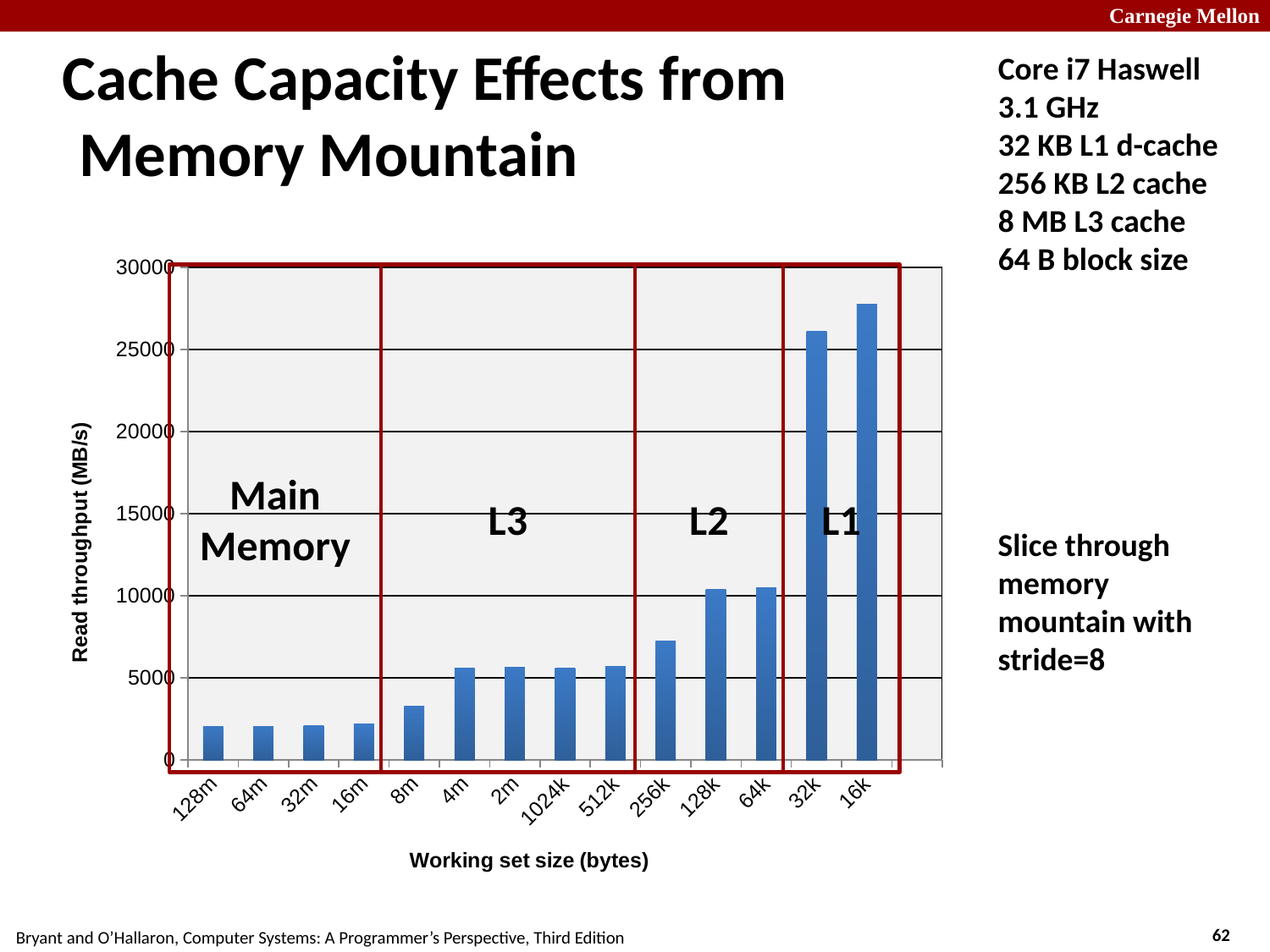
Which has the higher read throughput, a working set size of 32k or 16k? 16k How many working set sizes are plotted along the x axis? 14 Is the read throughput for a working set size of 256k greater or less than 10000 MB/s? less Which has the higher read throughput, a working set size of 256k or 512k? 256k What kind of chart is shown on the slide? bar chart Which working set size has the highest read throughput? 16k Is the read throughput for a working set size of 4m greater or less than 5000 MB/s? greater Is the read throughput for a working set size of 128k greater or less than 15000 MB/s? less Do the read throughput values generally rise or fall moving from left to right along the x axis? rise What is the label of the y axis? Read throughput (MB/s)